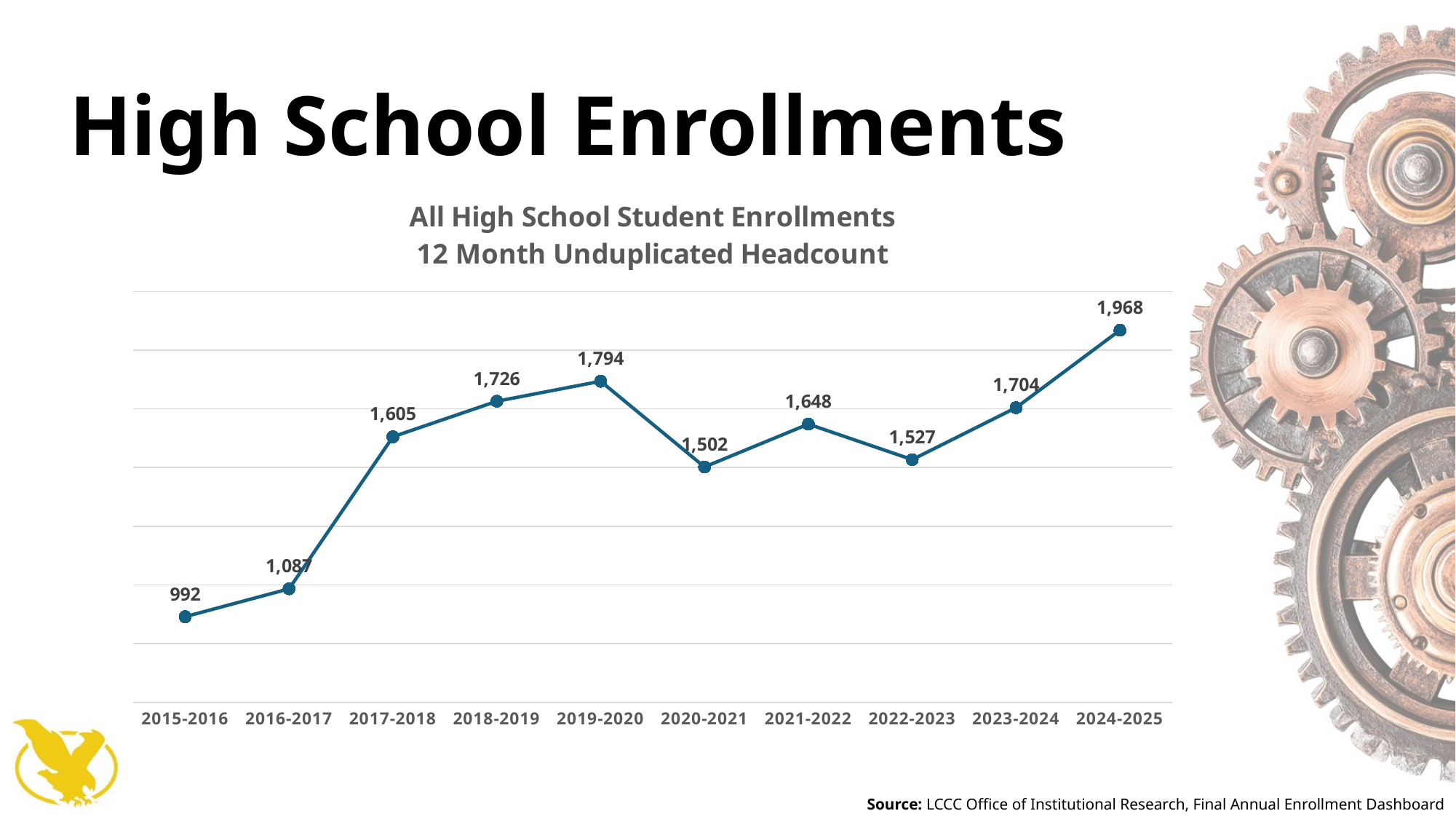
Did enrollment rise or fall from 2016-2017 to 2017-2018? Rise What is the high school enrollment headcount for 2015-2016? 992 What is the high school enrollment headcount for 2022-2023? 1,527 What is the high school enrollment headcount for 2019-2020? 1,794 How many academic years are plotted on the chart? 10 What kind of chart is shown on the slide? Line chart Which academic year has the highest high school enrollment? 2024-2025 Which year had higher enrollment, 2021-2022 or 2022-2023? 2021-2022 Which academic year has the lowest high school enrollment? 2015-2016 What is the title of the chart? All High School Student Enrollments 12 Month Unduplicated Headcount What is the difference in enrollment between 2024-2025 and 2023-2024? 264 What is the difference in enrollment between 2019-2020 and 2020-2021? 292